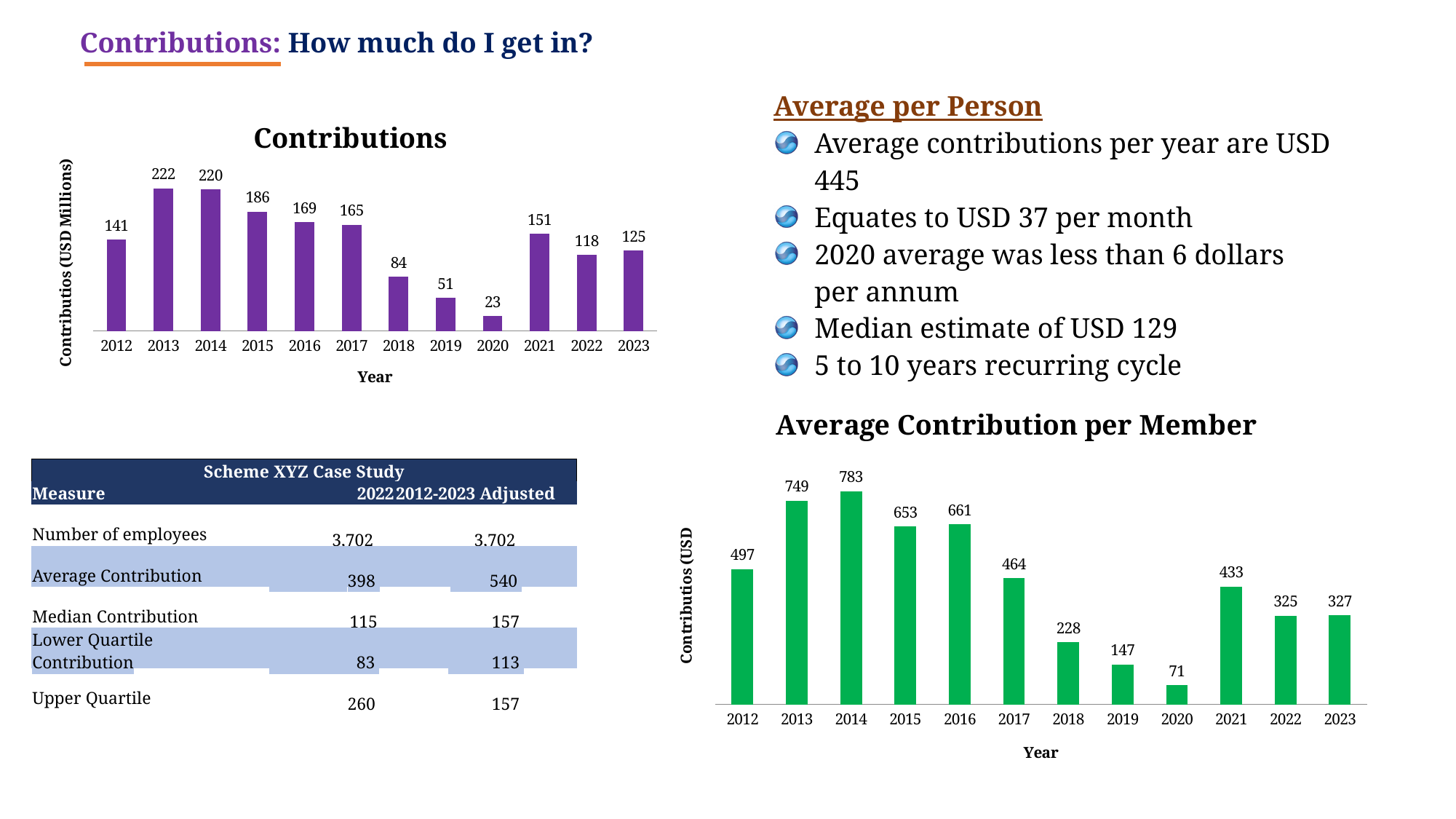
In the "Contributions" chart, what is the label on the y axis? Contributios (USD Millions) In the "Average Contribution per Member" chart, which is larger, the value for 2015 or the value for 2016? 2016 In the "Average Contribution per Member" chart, what is the value for 2019? 147 In the "Contributions" chart, which year has the lowest value? 2020 In the "Contributions" chart, what is the difference between the values for 2014 and 2023? 95 In the "Contributions" chart, what kind of chart is used? Bar chart In the "Average Contribution per Member" chart, what is the label on the x axis? Year In the "Contributions" chart, what is the value for 2013? 222 In the "Average Contribution per Member" chart, which year has the highest value? 2014 In the "Average Contribution per Member" chart, what is the difference between the values for 2013 and 2012? 252 In the "Contributions" chart, how many years are shown on the x axis? 12 In the "Contributions" chart, do the values rise or fall from 2017 to 2020? Fall